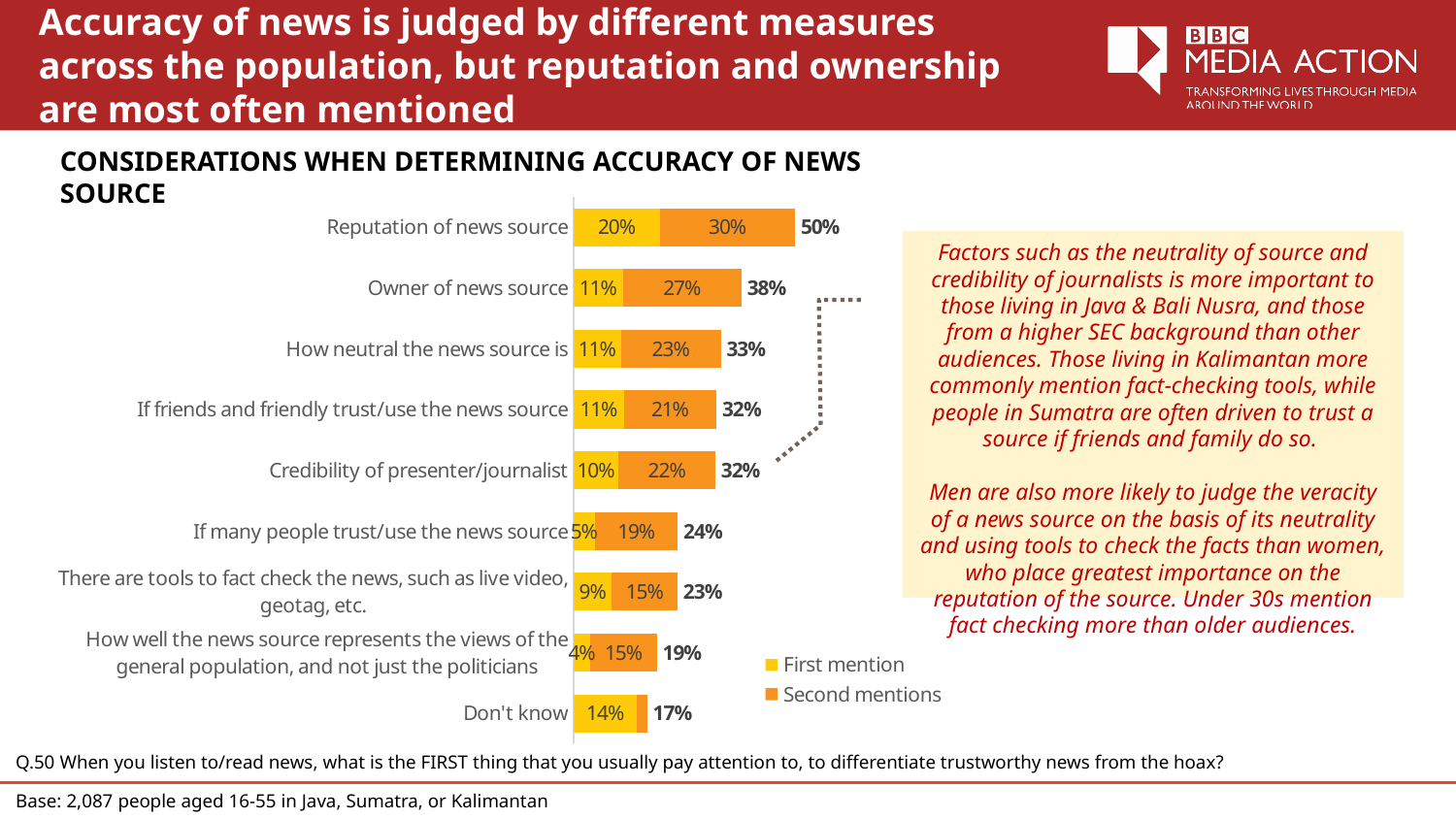
What are the two series named in the legend? First mention; Second mentions What is the First mention value for "Don't know"? 14% What is the First mention value for "Owner of news source"? 11% What is the Second mentions value for "How neutral the news source is"? 23% Which is larger: the total for "If many people trust/use the news source" or the total for "There are tools to fact check the news, such as live video, geotag, etc."? If many people trust/use the news source How many categories are shown in the chart? 9 What is the difference between the total for "Reputation of news source" and the total for "Owner of news source"? 12% How many series does the legend list? 2 What kind of chart is shown on the slide? Stacked bar chart Which category has the lowest total value? Don't know Which category has the highest total value? Reputation of news source What is the total value shown for "Reputation of news source"? 50%